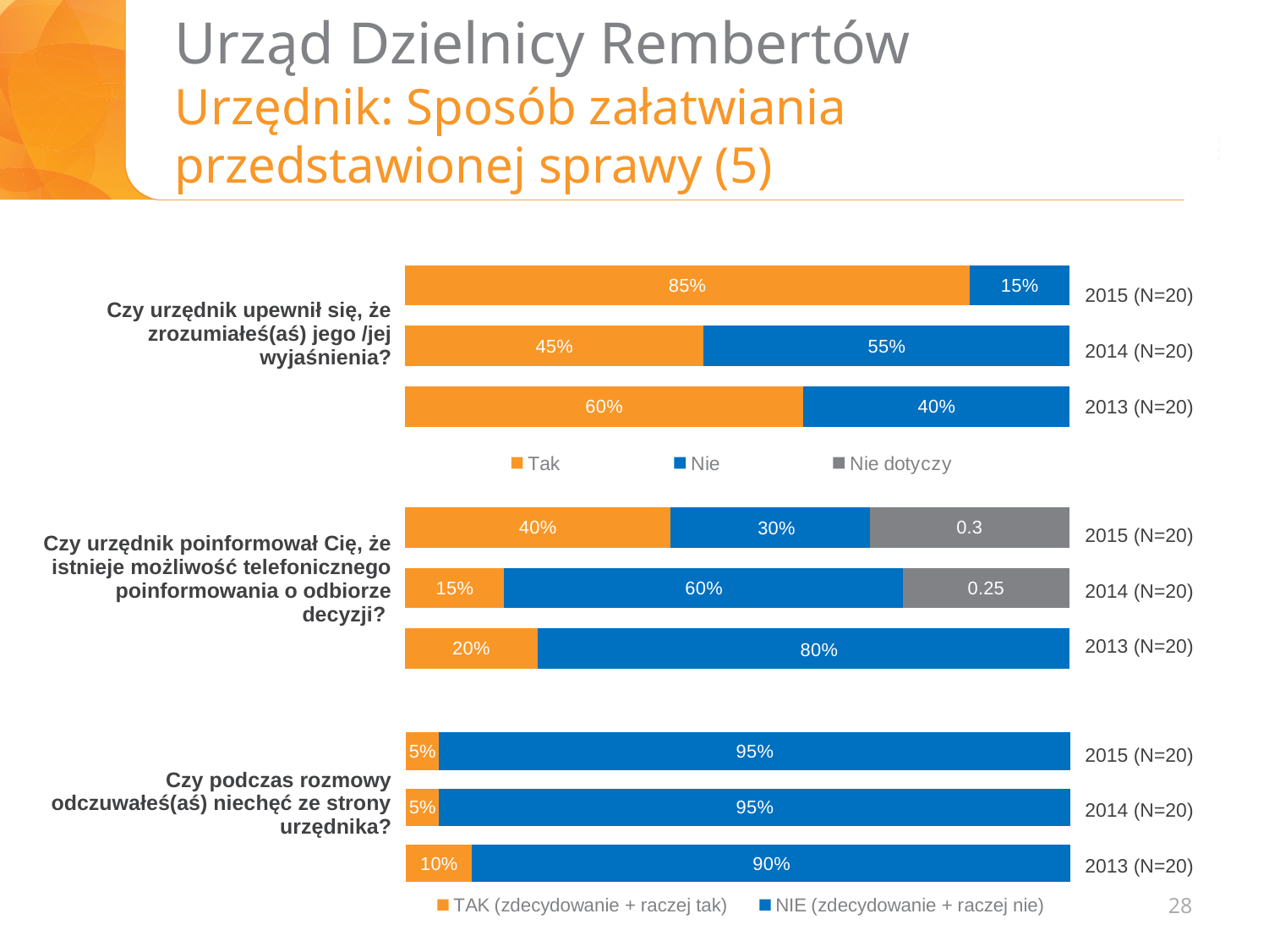
How many entries does the legend below the bottom chart list? 2 In the middle chart ("Czy urzędnik poinformował Cię, że istnieje możliwość telefonicznego poinformowania o odbiorze decyzji?"), what is the Nie value for 2013 (N=20)? 80% In the top chart ("Czy urzędnik upewnił się, że zrozumiałeś(aś) jego /jej wyjaśnienia?"), what is the Tak value for 2015 (N=20)? 85% In the middle chart ("Czy urzędnik poinformował Cię..."), what is the Nie dotyczy value shown for 2014 (N=20)? 0.25 In the bottom chart ("Czy podczas rozmowy odczuwałeś(aś) niechęć..."), which year has the highest TAK value? 2013 (N=20) What type of chart is used on this slide? Stacked bar chart In the top chart ("Czy urzędnik upewnił się..."), what is the difference between the Tak values for 2015 and 2014? 40 percentage points In the middle chart ("Czy urzędnik poinformował Cię..."), is the Tak value for 2015 larger or smaller than the Nie value for 2015? larger In the middle chart ("Czy urzędnik poinformował Cię..."), which year has the lowest Tak value? 2014 (N=20) In the bottom chart ("Czy podczas rozmowy odczuwałeś(aś) niechęć ze strony urzędnika?"), what is the NIE value for 2013 (N=20)? 90% In the top chart ("Czy urzędnik upewnił się..."), what is the Nie value for 2014 (N=20)? 55% In the top chart ("Czy urzędnik upewnił się..."), which year has the highest Tak value? 2015 (N=20)